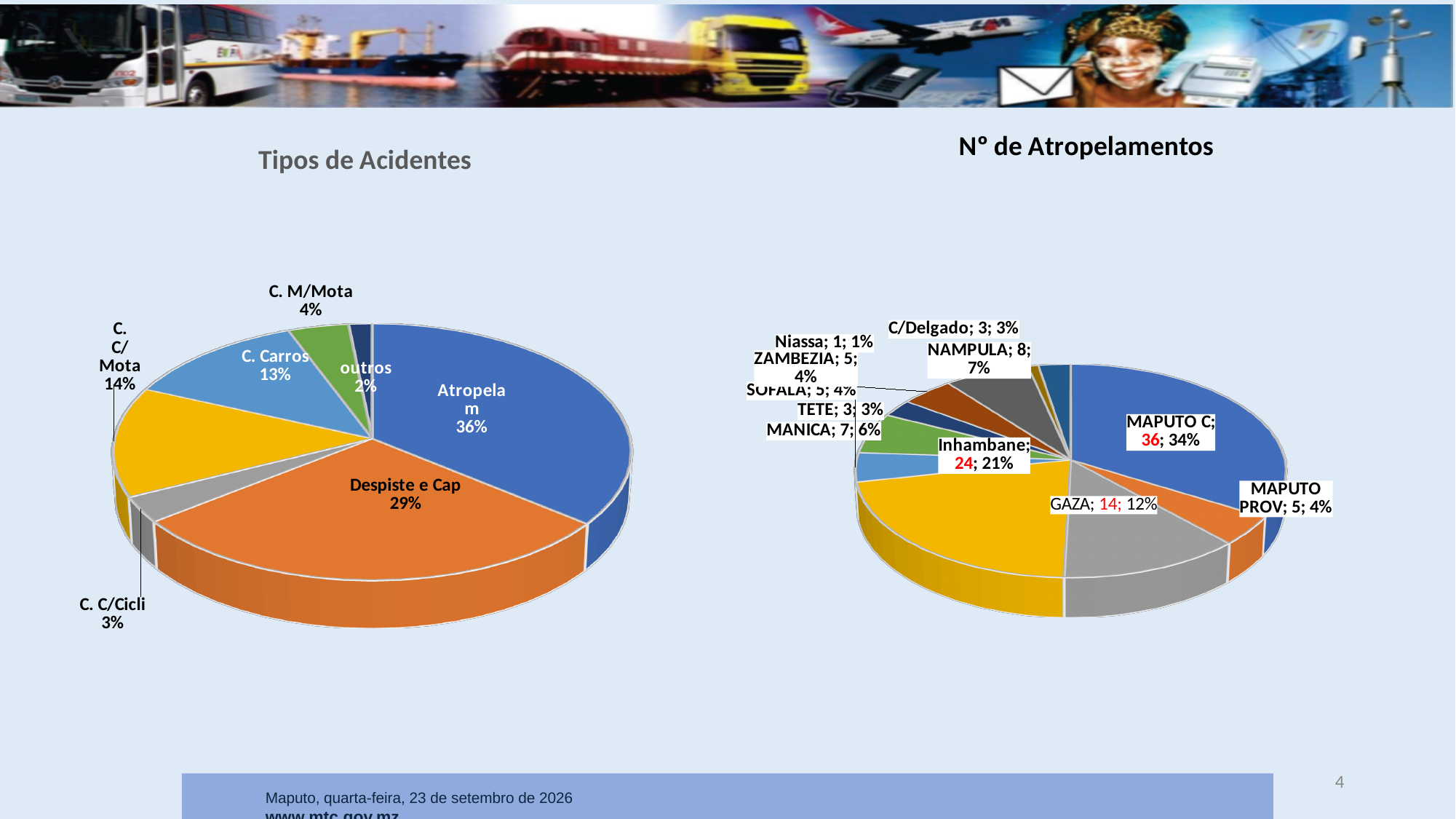
In the 'Tipos de Acidentes' chart, which category has the largest share? Atropelam In the 'Tipos de Acidentes' chart, how many categories are shown? 7 In the 'Nº de Atropelamentos' chart, how many provinces are shown? 11 In the 'Tipos de Acidentes' chart, what share is 'Despiste e Cap'? 29% In the 'Tipos de Acidentes' chart, what is the difference in percentage points between 'C. C/Mota' and 'C. Carros'? 1 In the 'Nº de Atropelamentos' chart, how many atropelamentos are recorded for MAPUTO C? 36 In the 'Nº de Atropelamentos' chart, what is the value for Inhambane? 24 In the 'Tipos de Acidentes' chart, what share of accidents is 'Atropelam'? 36% What kind of chart is 'Nº de Atropelamentos'? Pie chart In the 'Nº de Atropelamentos' chart, what is the difference between MAPUTO C and GAZA? 22 In the 'Tipos de Acidentes' chart, which category has the smallest share? outros In the 'Nº de Atropelamentos' chart, which province has the lowest number? Niassa